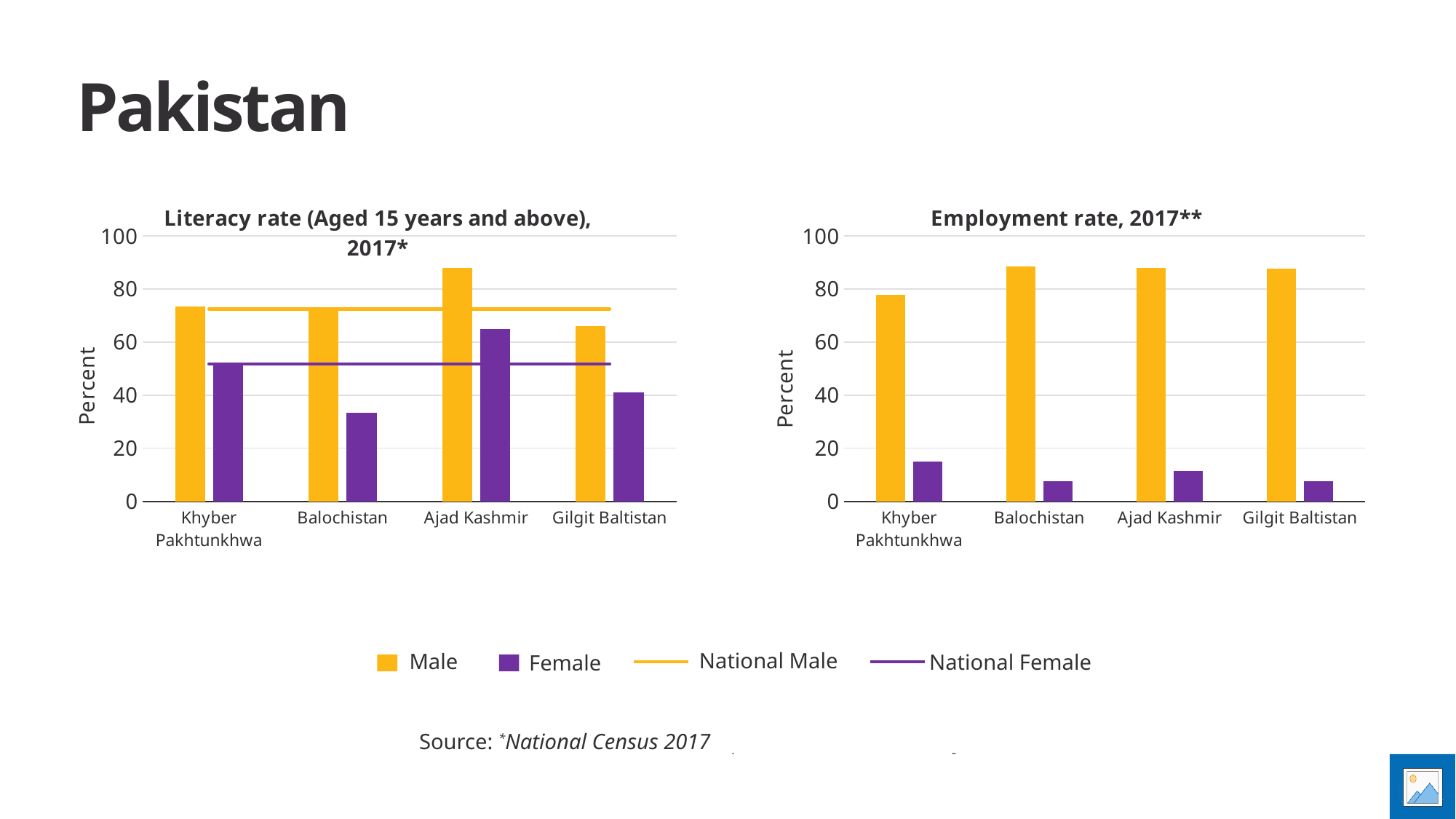
In the Literacy rate chart, which region has the highest female literacy rate? Ajad Kashmir In the Employment rate chart, is the female value for Khyber Pakhtunkhwa greater or less than 20? less In the Employment rate chart, which region has the highest female employment rate? Khyber Pakhtunkhwa In the Literacy rate chart, which region has the lowest male literacy rate? Gilgit Baltistan In the Employment rate chart, which region has the lowest male employment rate? Khyber Pakhtunkhwa In the Literacy rate chart, is the male value for Ajad Kashmir greater or less than 80? greater In the Literacy rate chart, which region has the highest male literacy rate? Ajad Kashmir How many regions are shown on the x axis of the Employment rate chart? 4 In the Literacy rate chart, which region has the lowest female literacy rate? Balochistan How many entries does the shared legend at the bottom of the slide list? 4 In the Literacy rate chart, is the female value for Balochistan greater or less than 40? less